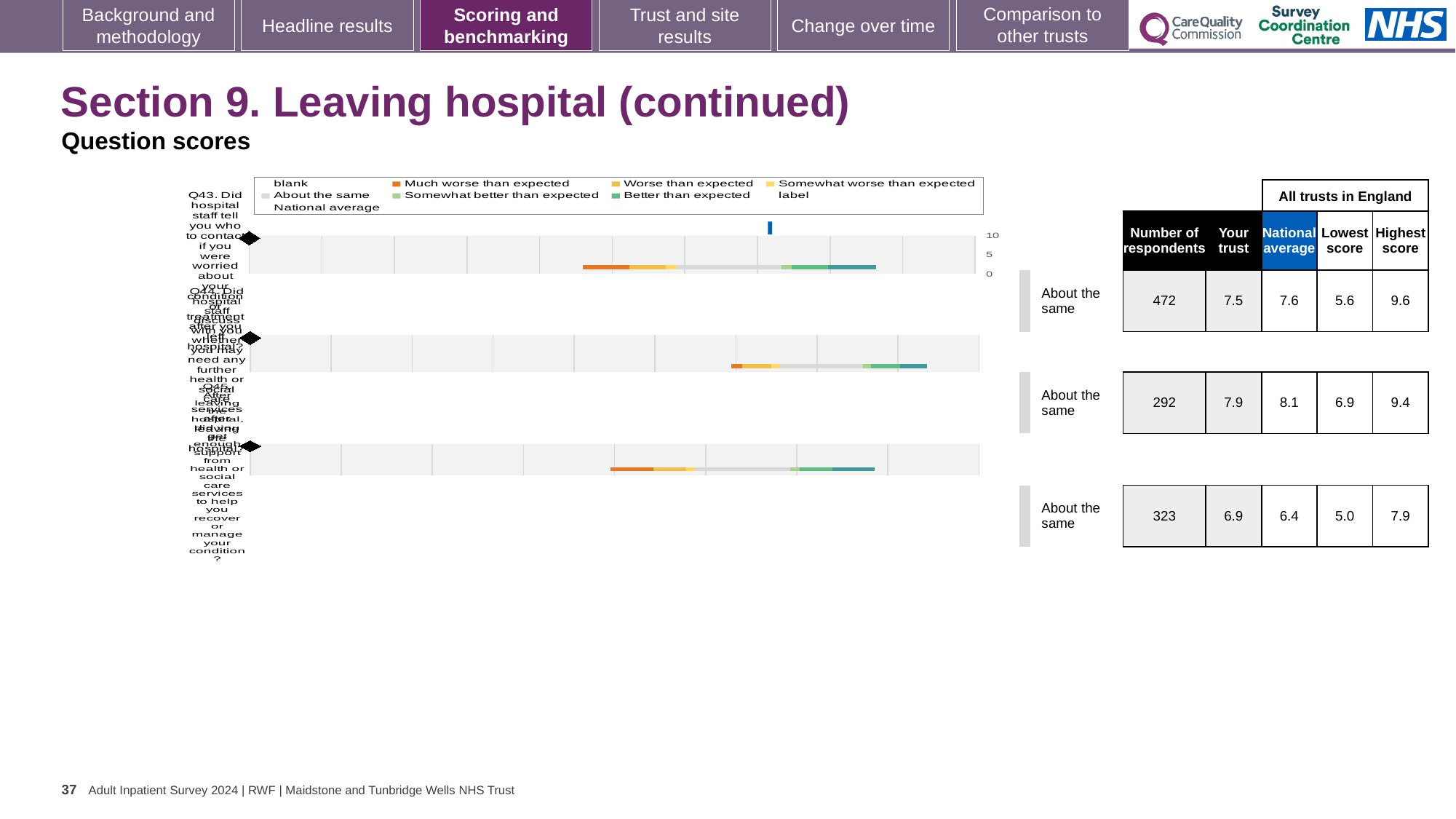
What is the 'Your trust' score for the first (top) question row, Q43? 7.5 What is the highest score among all trusts in England for the third (bottom) question row? 7.9 What is the national average for the second question row? 8.1 What kind of chart is shown on the slide? bar chart For the first (top) question row, which is larger: the 'Your trust' score or the national average? National average How many question rows are plotted in the chart? 3 What is the lowest score among all trusts in England for the second question row? 6.9 Which question row has the highest 'Your trust' score? the second row What is the number of respondents for the first (top) question row, Q43? 472 What benchmark category is shown next to each of the three question rows? About the same Which question row has the lowest number of respondents? the second row For the third (bottom) question row, what is the difference between the 'Your trust' score and the national average? 0.5